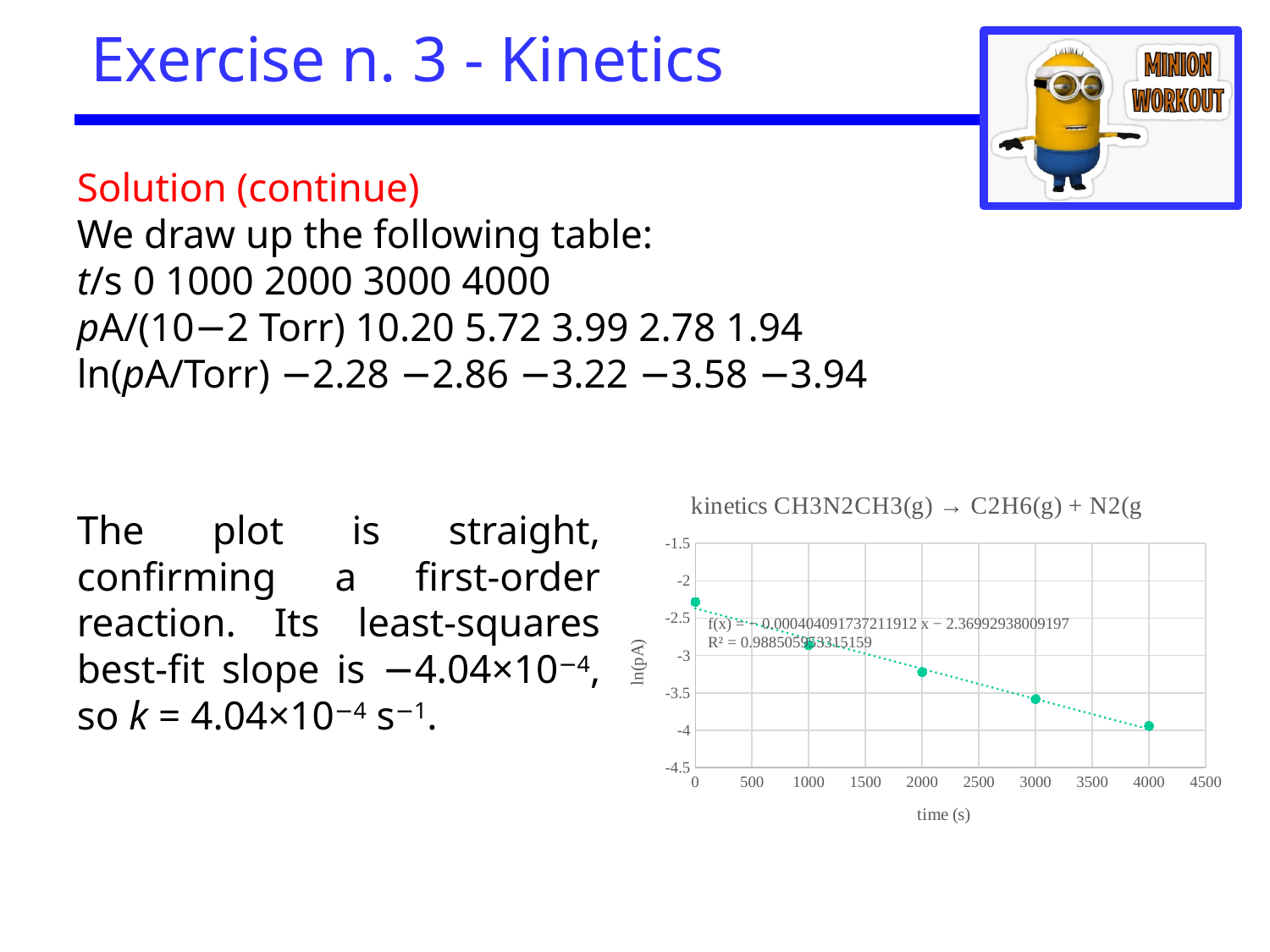
What R² value is printed on the chart for the fitted line? R² = 0.988505953315159 What is the title of the x axis of the chart? time (s) At which time (s) is the plotted ln(pA) value highest? 0 At which time (s) is the plotted ln(pA) value lowest? 4000 What is the title of the y axis of the chart? ln(pA) Is the ln(pA) value at time 4000 s greater or less than -3.5? less What kind of chart is shown on the slide? scatter chart Is the ln(pA) value at time 0 s greater or less than -2.5? greater Do the ln(pA) values rise or fall as time increases along the x axis? fall Which has the larger ln(pA) value, the point at 1000 s or the point at 3000 s? 1000 s How many data points are plotted in the chart? 5 Is the ln(pA) value at time 2000 s greater or less than -3? less